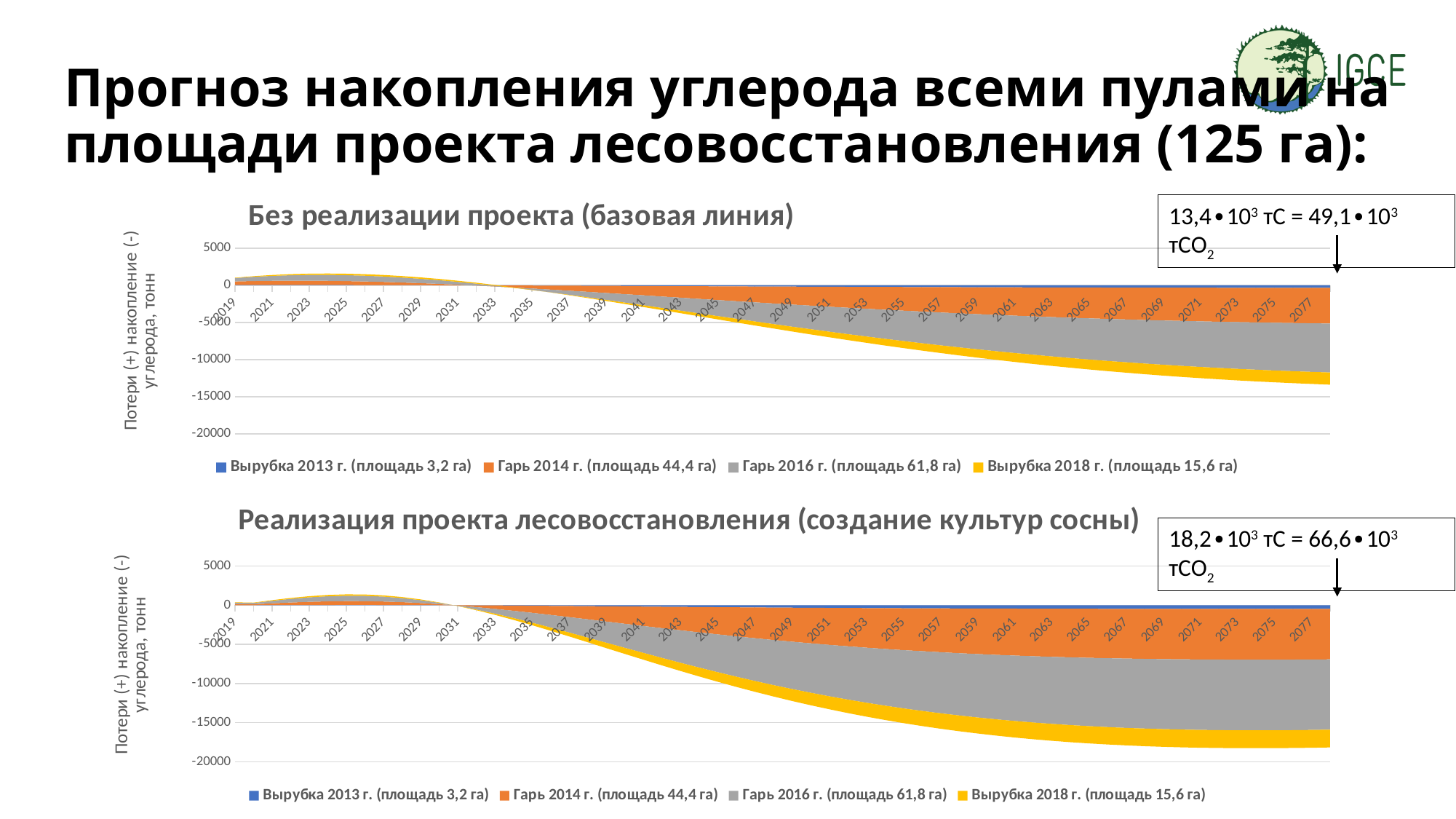
What kind of chart is the top chart titled "Без реализации проекта (базовая линия)"? Area chart How many series does the legend of the top chart "Без реализации проекта (базовая линия)" list? 4 Which chart reaches a lower (more negative) total stacked value in 2077: the top chart "Без реализации проекта (базовая линия)" or the bottom chart "Реализация проекта лесовосстановления"? The bottom chart (Реализация проекта лесовосстановления) What is the first year shown on the x axis of the top chart "Без реализации проекта (базовая линия)"? 2019 In the top chart "Без реализации проекта (базовая линия)", is the total stacked value in 2077 greater or less than -15000? greater In the bottom chart "Реализация проекта лесовосстановления (создание культур сосны)", is the total stacked value in 2077 greater or less than -15000? less In the top chart "Без реализации проекта (базовая линия)", is the total stacked value in 2077 greater or less than -10000? less What is the lowest value labeled on the y axis of the bottom chart "Реализация проекта лесовосстановления (создание культур сосны)"? -20000 In the top chart "Без реализации проекта (базовая линия)", do the stacked values rise or fall along the x axis after about 2033? Fall How many year labels are shown on the x axis of the bottom chart "Реализация проекта лесовосстановления (создание культур сосны)"? 30 In the top chart "Без реализации проекта (базовая линия)", what area is given in the legend for the series "Гарь 2016 г."? 61,8 га In the bottom chart "Реализация проекта лесовосстановления (создание культур сосны)", which series is shown in yellow? Вырубка 2018 г. (площадь 15,6 га)